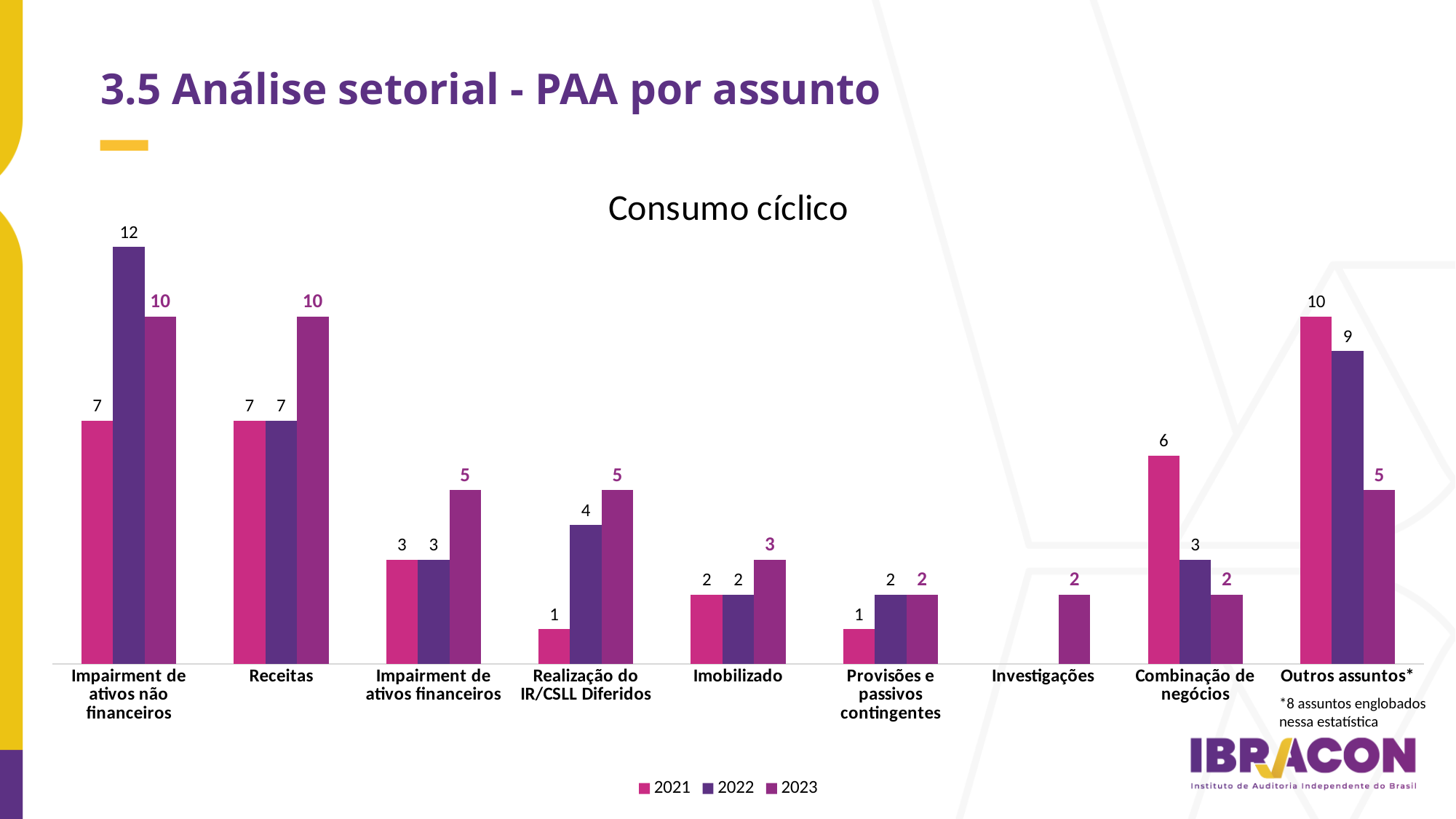
How many categories are shown on the x axis of the chart? 9 What is the value for 2022 in the Impairment de ativos não financeiros category? 12 Which category has the highest value for the 2021 series? Outros assuntos* What is the value for 2021 in the Combinação de negócios category? 6 What is the title of the chart? Consumo cíclico What is the difference between the 2021 and 2023 values for Outros assuntos*? 5 What kind of chart is shown on the slide? Bar chart Which category has the highest value for the 2022 series? Impairment de ativos não financeiros Which is larger for Combinação de negócios: the 2021 value or the 2023 value? 2021 How many series does the legend list? 3 What is the value for 2022 in the Realização do IR/CSLL Diferidos category? 4 What is the value for 2023 in the Receitas category? 10